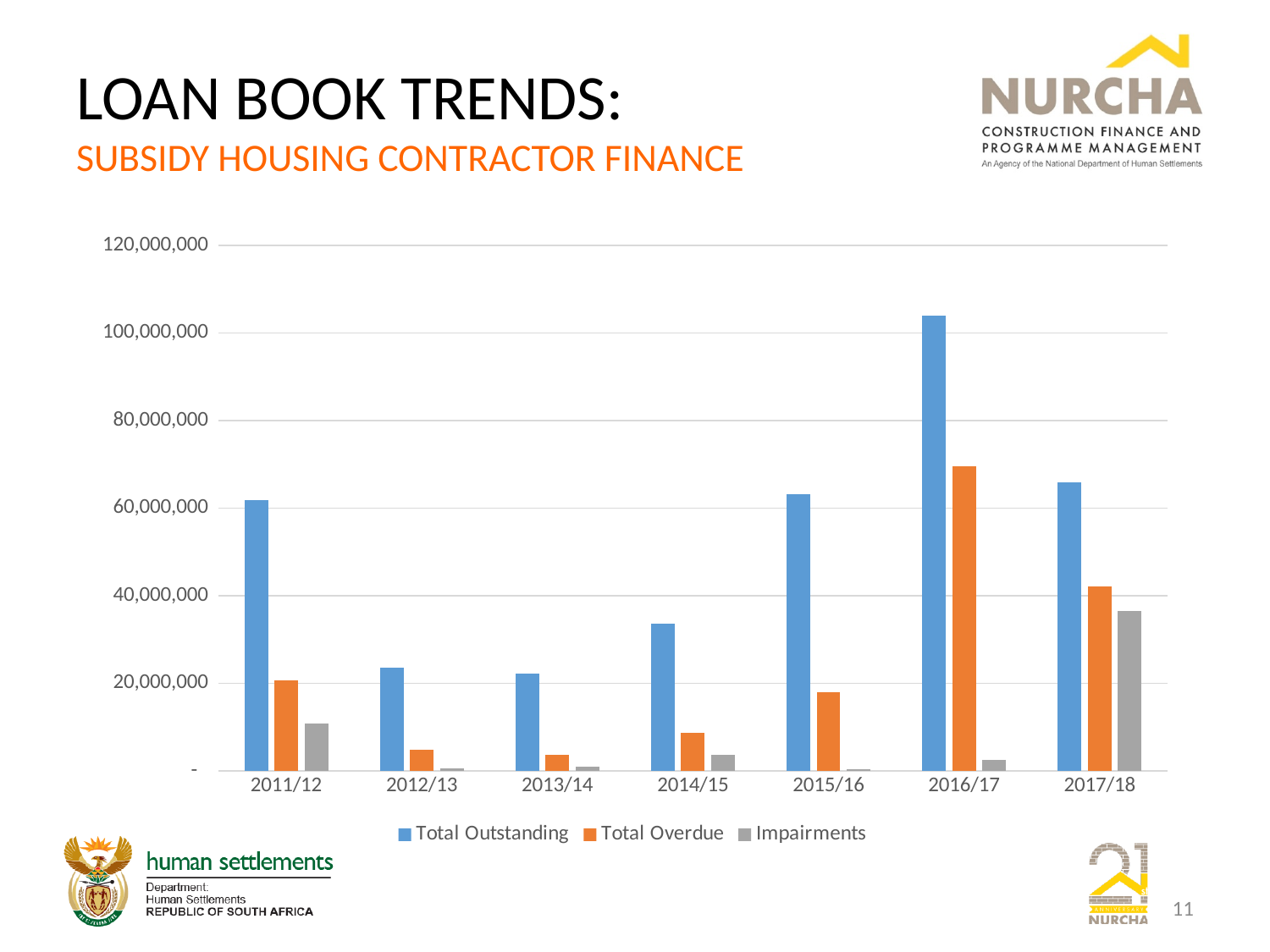
How many series does the legend list? 3 Does Total Outstanding rise or fall from 2013/14 to 2016/17? Rise Which is larger in 2017/18: Total Outstanding or Total Overdue? Total Outstanding In which year is Total Outstanding highest? 2016/17 What colour represents Total Overdue in the legend? Orange Is the Total Outstanding value for 2014/15 greater or less than 40,000,000? less Is the Total Overdue value for 2016/17 greater or less than 60,000,000? greater Is the Total Outstanding value for 2016/17 greater or less than 100,000,000? greater Which is larger: Impairments in 2011/12 or Impairments in 2014/15? 2011/12 How many financial years are shown on the x axis? 7 What kind of chart is shown on the slide? Bar chart In which year is Impairments highest? 2017/18